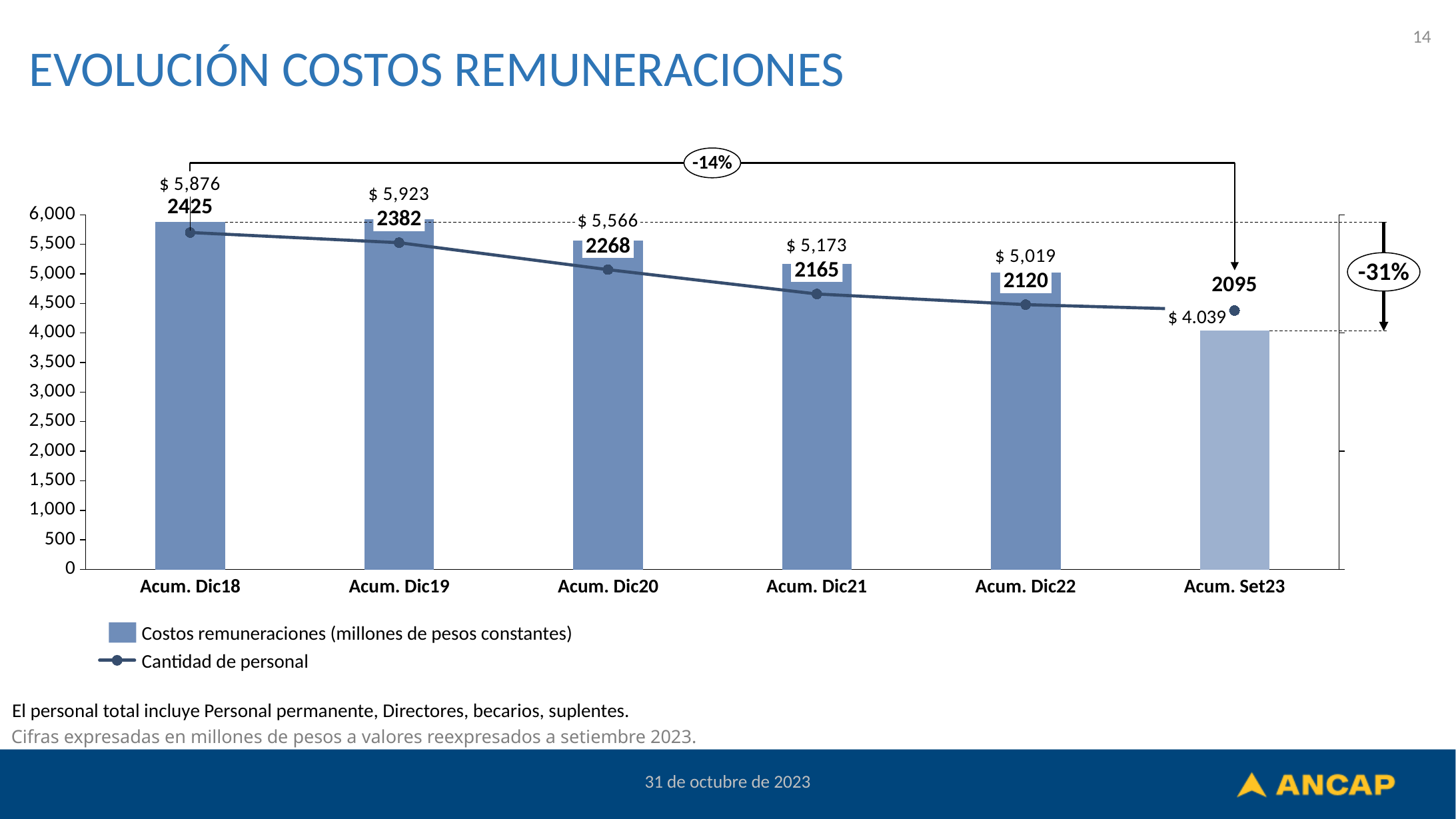
What is the value of Costos remuneraciones for Acum. Set23? $ 4.039 How many series does the legend list? 2 What is the value of Costos remuneraciones for Acum. Dic20? $ 5,566 Which period has the lowest Cantidad de personal? Acum. Set23 Does the Cantidad de personal line rise or fall from Acum. Dic18 to Acum. Set23? fall How many periods are shown on the x axis? 6 What is the Cantidad de personal for Acum. Dic21? 2165 Which is larger, the Costos remuneraciones for Acum. Dic21 or for Acum. Dic22? Acum. Dic21 Is the Costos remuneraciones bar for Acum. Set23 greater or less than 4,500? less Which period has the highest Costos remuneraciones? Acum. Dic19 What kind of chart is used for the Costos remuneraciones series? bar chart What is the difference in Cantidad de personal between Acum. Dic18 and Acum. Dic22? 305